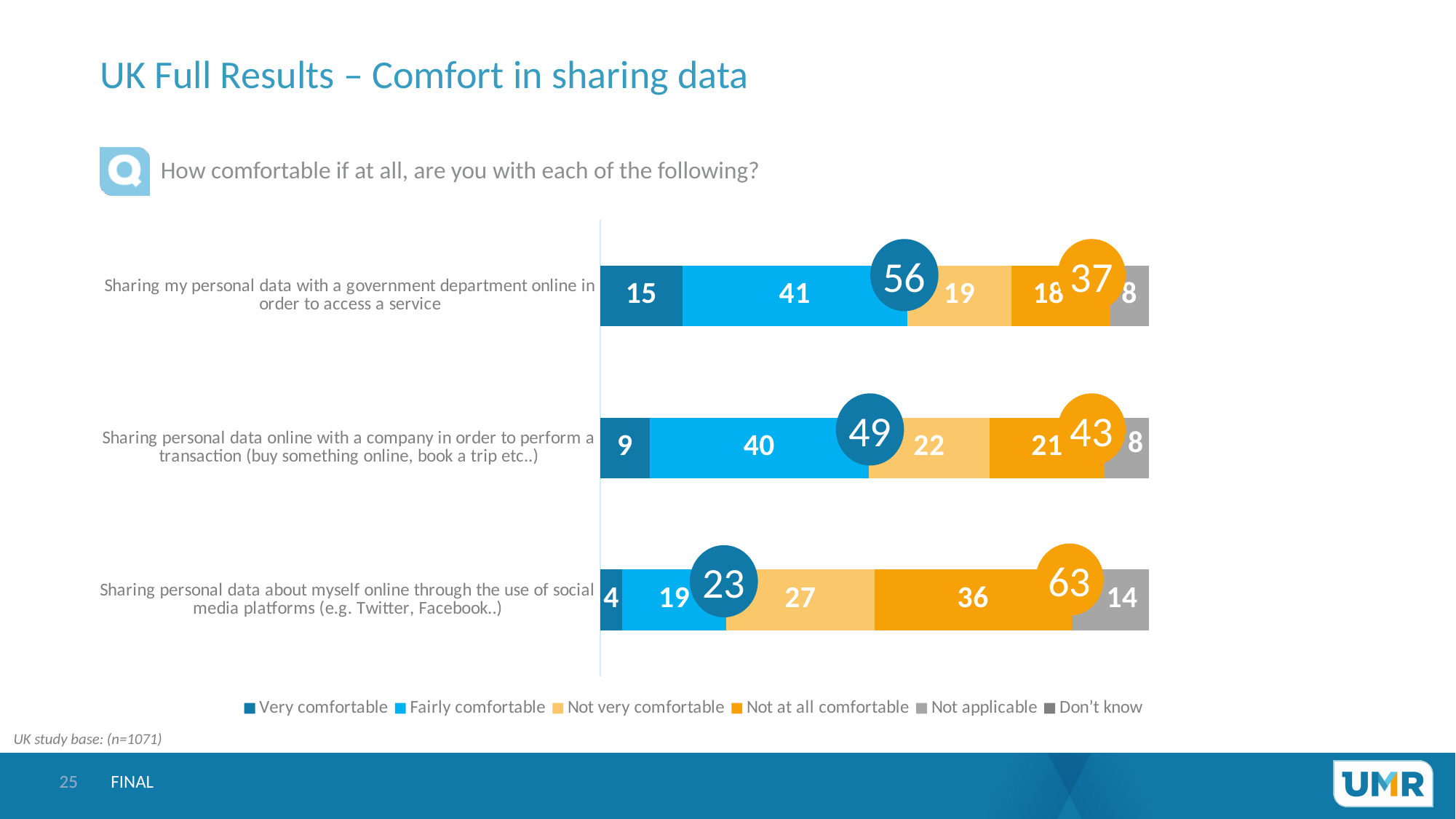
What type of chart is shown on the slide? Stacked bar chart What is the combined 'Very comfortable' and 'Fairly comfortable' value shown in the blue circle for sharing personal data online with a company in order to perform a transaction? 49 How many series does the legend list? 6 What is the 'Fairly comfortable' value for sharing personal data online with a company in order to perform a transaction? 40 Which is larger: the 'Not very comfortable' value for the government department statement or for the social media statement? Social media statement (27) How many categories (statements) are plotted in the chart? 3 Which statement has the lowest 'Very comfortable' value? Sharing personal data about myself online through the use of social media platforms What is the 'Not very comfortable' value for sharing personal data online with a company in order to perform a transaction? 22 What is the 'Not at all comfortable' value for sharing personal data about myself online through the use of social media platforms? 36 What is the 'Very comfortable' value for sharing personal data with a government department online in order to access a service? 15 Which statement has the highest 'Not at all comfortable' value? Sharing personal data about myself online through the use of social media platforms What is the difference between the 'Fairly comfortable' values for the government department statement and the social media statement? 22